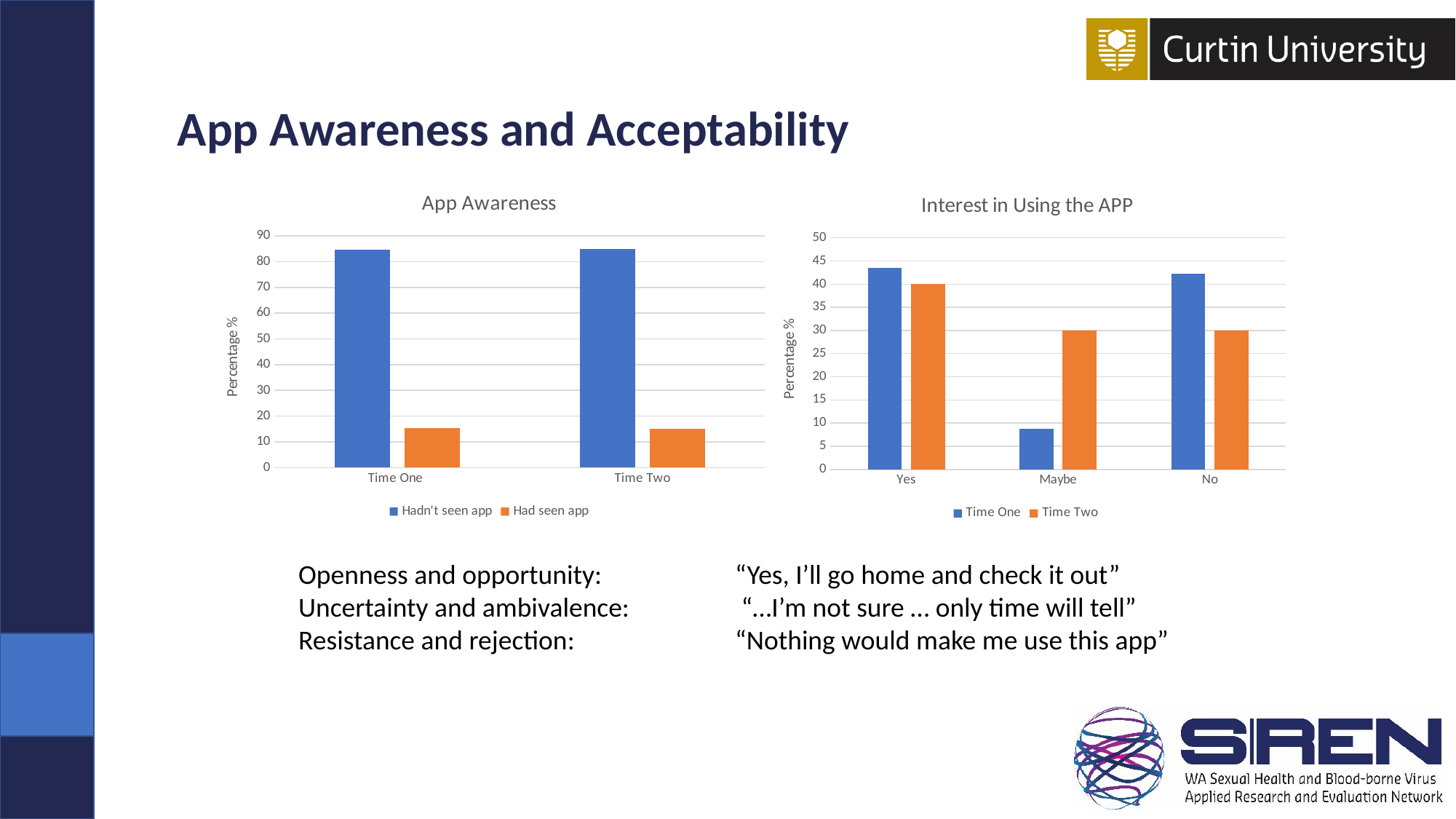
What kind of chart is the App Awareness chart? bar chart In the Interest in Using the APP chart, is the value for Maybe at Time One greater or less than 10? less In the App Awareness chart, is the value for Had seen app at Time Two greater or less than 20? less In the Interest in Using the APP chart, which category has the lowest value for Time One? Maybe In the Interest in Using the APP chart, which category has the highest value for Time Two? Yes In the Interest in Using the APP chart, which is larger for Maybe, Time One or Time Two? Time Two In the App Awareness chart, which series is larger at Time One, Hadn't seen app or Had seen app? Hadn't seen app In the App Awareness chart, is the value for Hadn't seen app at Time One greater or less than 80? greater How many series does the legend of the App Awareness chart list? 2 How many categories are shown on the x axis of the App Awareness chart? 2 How many categories are shown on the x axis of the Interest in Using the APP chart? 3 What is the y-axis label of the Interest in Using the APP chart? Percentage %